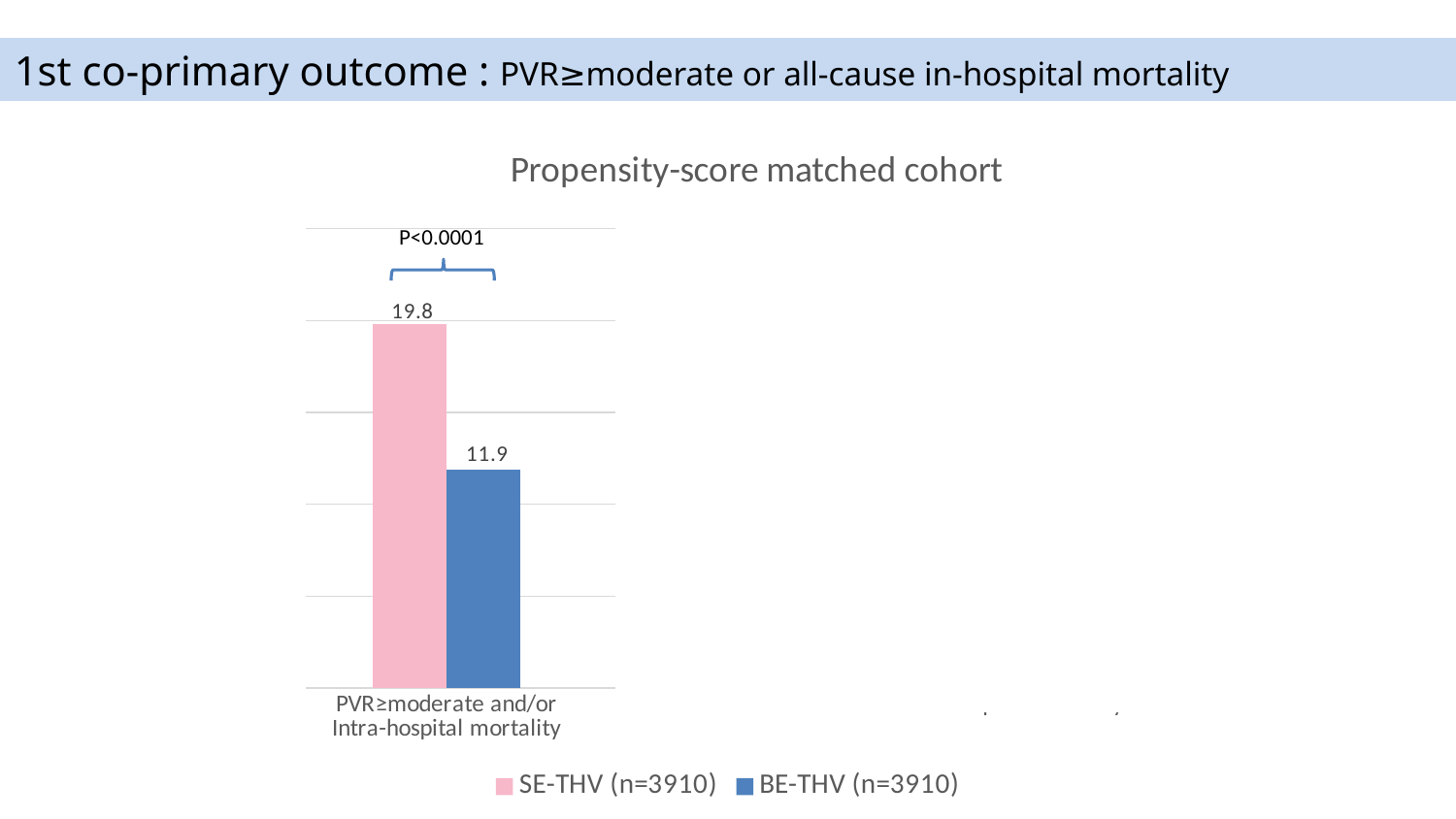
What p-value is shown above the bars in the chart? P<0.0001 Which series has the lower value for PVR≥moderate and/or Intra-hospital mortality? BE-THV (n=3910) What is the title of the chart? Propensity-score matched cohort What is the value for SE-THV (n=3910) in the PVR≥moderate and/or Intra-hospital mortality category? 19.8 What is the difference between the SE-THV (n=3910) and BE-THV (n=3910) values? 7.9 Is the value for SE-THV (n=3910) larger or smaller than the value for BE-THV (n=3910)? larger How many series does the legend list? 2 What is the value for BE-THV (n=3910) in the PVR≥moderate and/or Intra-hospital mortality category? 11.9 Which series has the higher value for PVR≥moderate and/or Intra-hospital mortality? SE-THV (n=3910) What kind of chart is shown on the slide? bar chart How many categories are shown on the x axis of the chart? 1